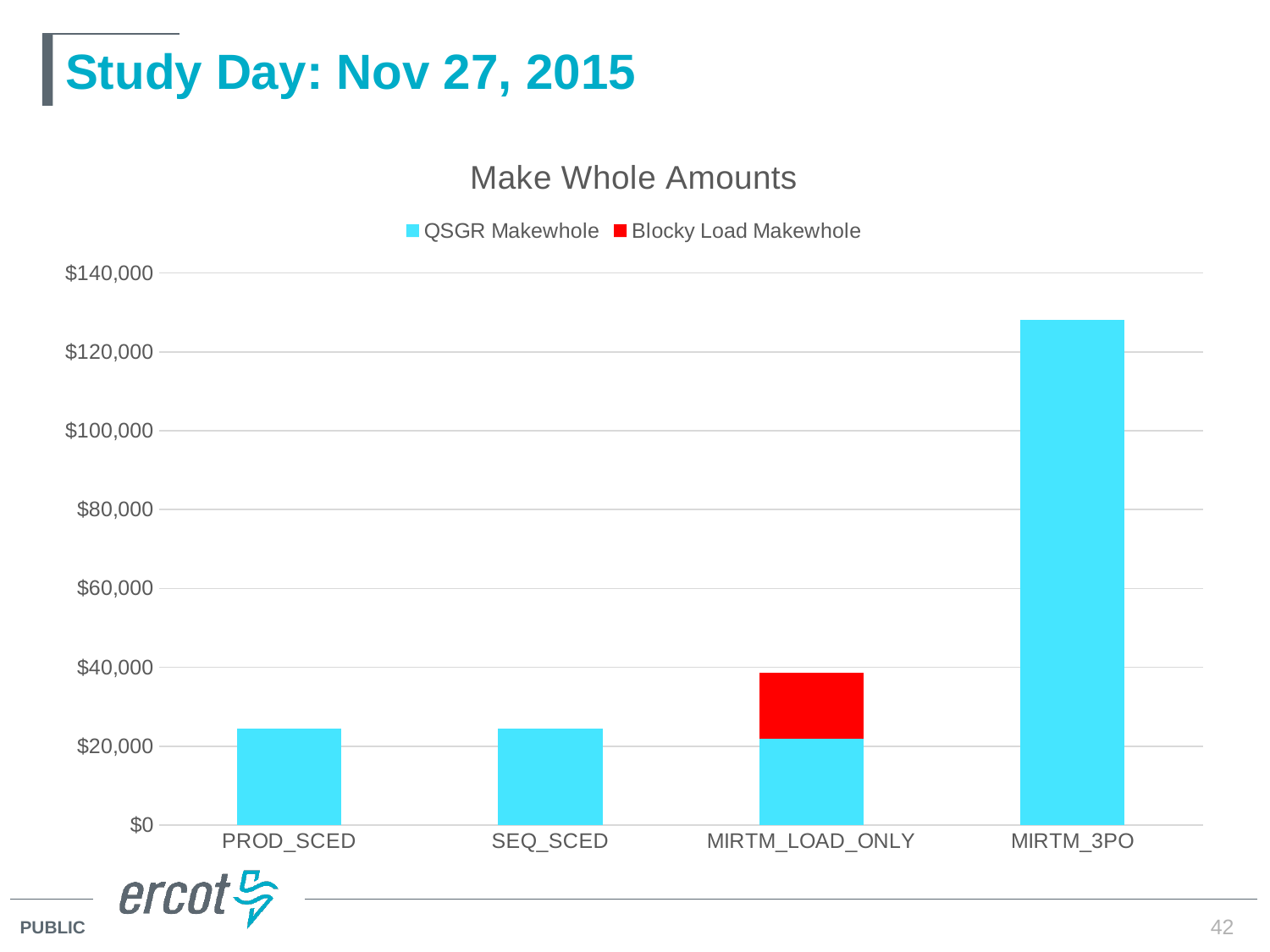
Is the total value for MIRTM_LOAD_ONLY greater or less than $40,000? less Which is larger, the total for MIRTM_LOAD_ONLY or the total for PROD_SCED? MIRTM_LOAD_ONLY Is the value for PROD_SCED greater or less than $40,000? less How many series does the legend list? 2 Which category is the only one with a Blocky Load Makewhole segment? MIRTM_LOAD_ONLY Is the total value for MIRTM_LOAD_ONLY greater or less than $20,000? greater What kind of chart is shown on the slide? bar chart Which is larger, the total for MIRTM_3PO or the total for SEQ_SCED? MIRTM_3PO How many categories are shown on the x axis? 4 Which category has the highest total make whole amount? MIRTM_3PO What is the title of the chart? Make Whole Amounts